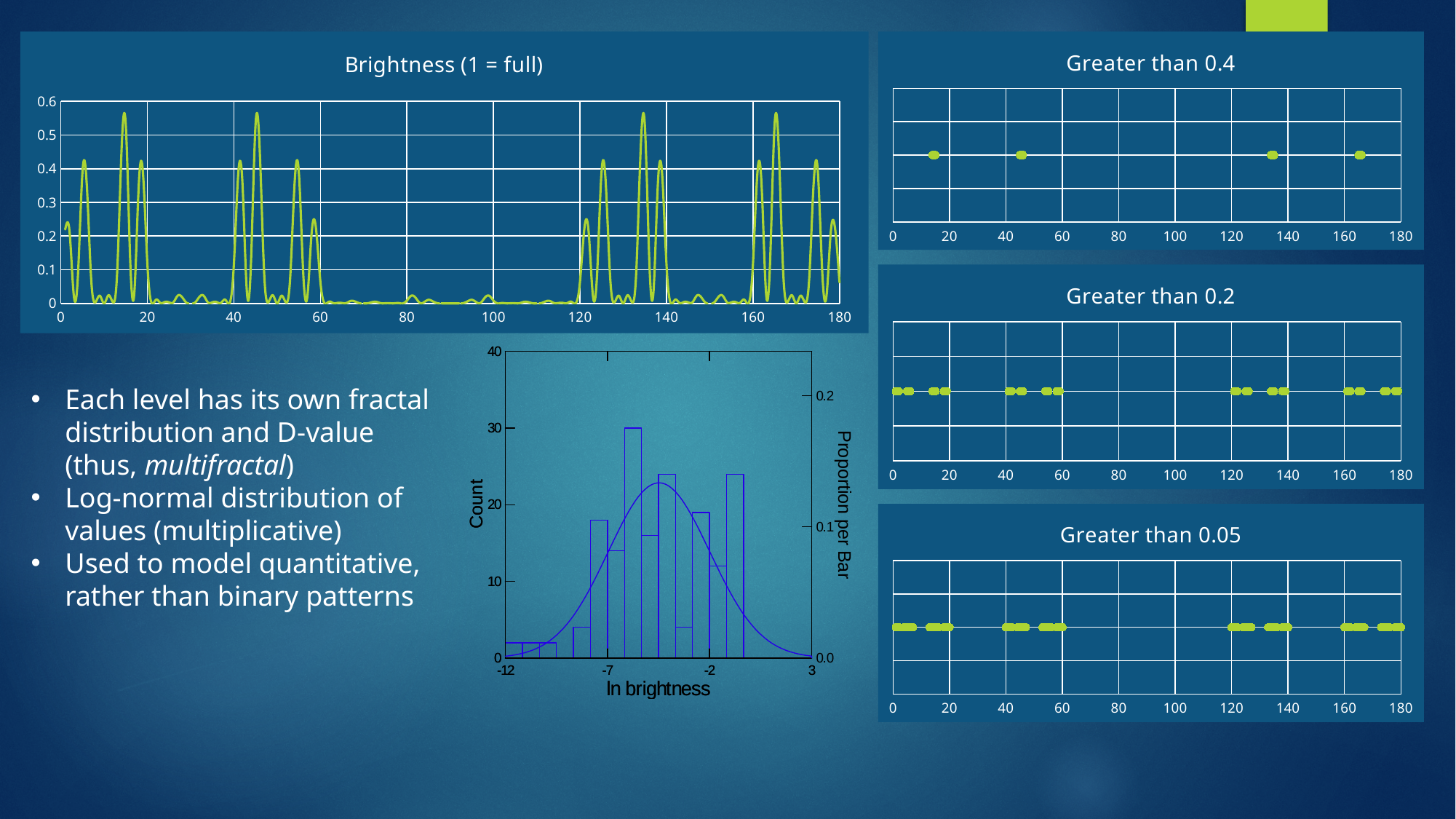
What is the largest x-axis tick value on the "Greater than 0.2" chart? 180 On the "ln brightness" chart, is the tallest bar greater or less than 20? greater On the "ln brightness" chart, what is the label of the left y axis? Count What kind of chart is the "Brightness (1 = full)" chart? line chart On the "Brightness (1 = full)" chart, what is the highest value shown on the y axis? 0.6 On the "Brightness (1 = full)" chart, is the peak near x = 5 greater or less than 0.5? less On the "Brightness (1 = full)" chart, is the value near x = 100 greater or less than 0.1? less Which of the three "Greater than" charts on the right has the fewest plotted points? Greater than 0.4 What kind of chart is the chart with the x axis labelled "ln brightness"? bar chart On the "ln brightness" chart, what is the count of the tallest bar? 30